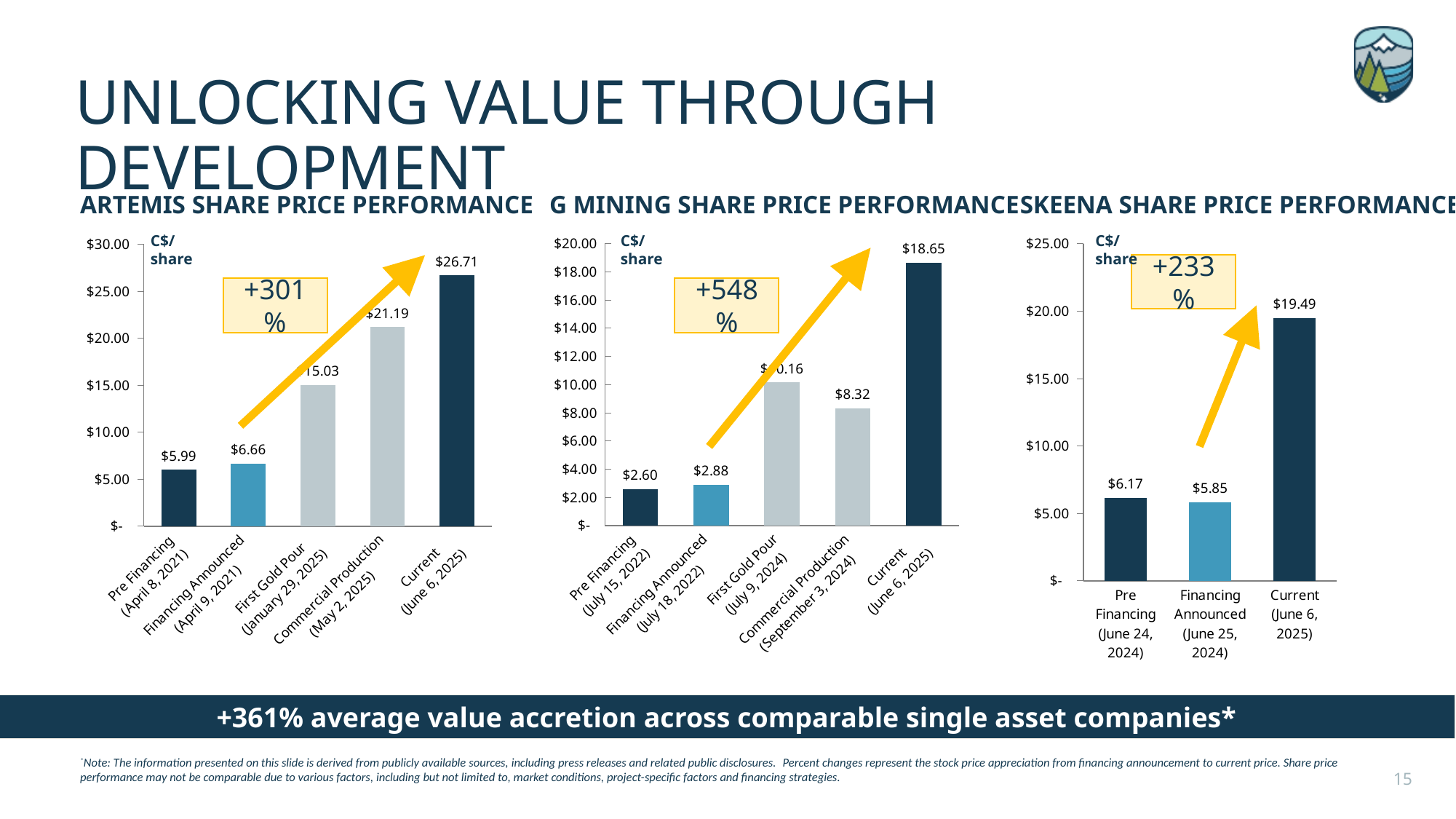
In the Artemis Share Price Performance chart, what is the difference between the Current (June 6, 2025) value and the Financing Announced (April 9, 2021) value? $20.05 In the Skeena Share Price Performance chart, which is larger: Pre Financing (June 24, 2024) or Financing Announced (June 25, 2024)? Pre Financing (June 24, 2024) In the Artemis Share Price Performance chart, what is the value for Pre Financing (April 8, 2021)? $5.99 In the Artemis Share Price Performance chart, what is the value for Current (June 6, 2025)? $26.71 In the G Mining Share Price Performance chart, what is the value for Commercial Production (September 3, 2024)? $8.32 In the G Mining Share Price Performance chart, which category has the lowest value? Pre Financing (July 15, 2022) In the G Mining Share Price Performance chart, what is the value for Current (June 6, 2025)? $18.65 In the Artemis Share Price Performance chart, how many categories are shown on the x axis? 5 What kind of chart is the Skeena Share Price Performance chart? Bar chart In the Skeena Share Price Performance chart, what is the value for Current (June 6, 2025)? $19.49 In the G Mining Share Price Performance chart, is the value for First Gold Pour (July 9, 2024) greater or less than $8.00? greater In the Skeena Share Price Performance chart, how many categories are shown on the x axis? 3